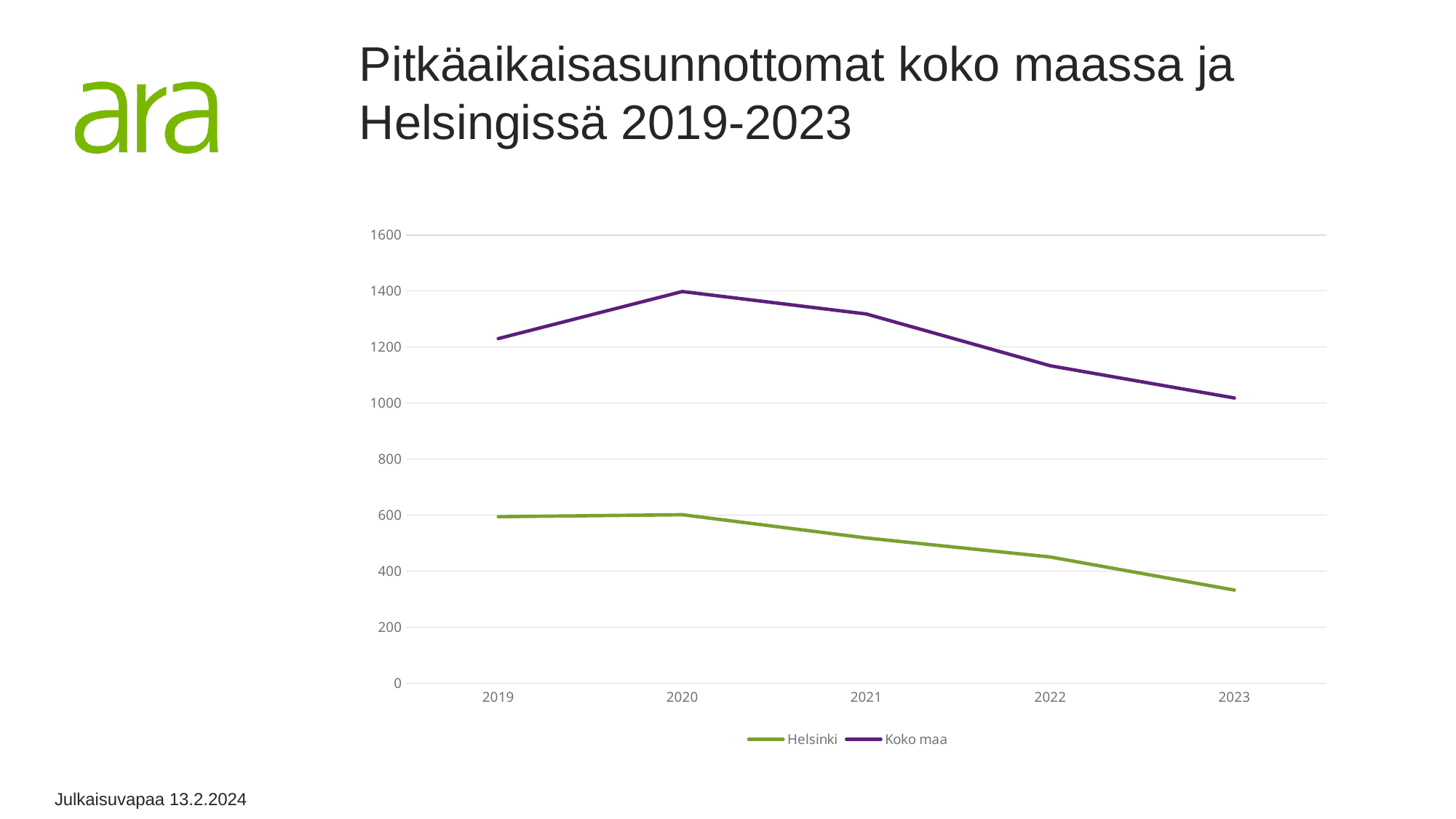
Is the value for Koko maa in 2022 greater or less than 1000? greater Do the Helsinki values rise or fall from 2020 to 2023? fall Is the value for Helsinki in 2023 greater or less than 400? less Which is larger for Koko maa: the value in 2020 or the value in 2021? 2020 In which year is the Koko maa series at its highest? 2020 In which year is the Koko maa series at its lowest? 2023 How many years are plotted along the x axis? 5 What kind of chart is shown on the slide? line chart In which year is the Helsinki series at its lowest? 2023 Which series is drawn with the green line? Helsinki Is the value for Koko maa in 2019 greater or less than 1200? greater How many series does the legend list? 2